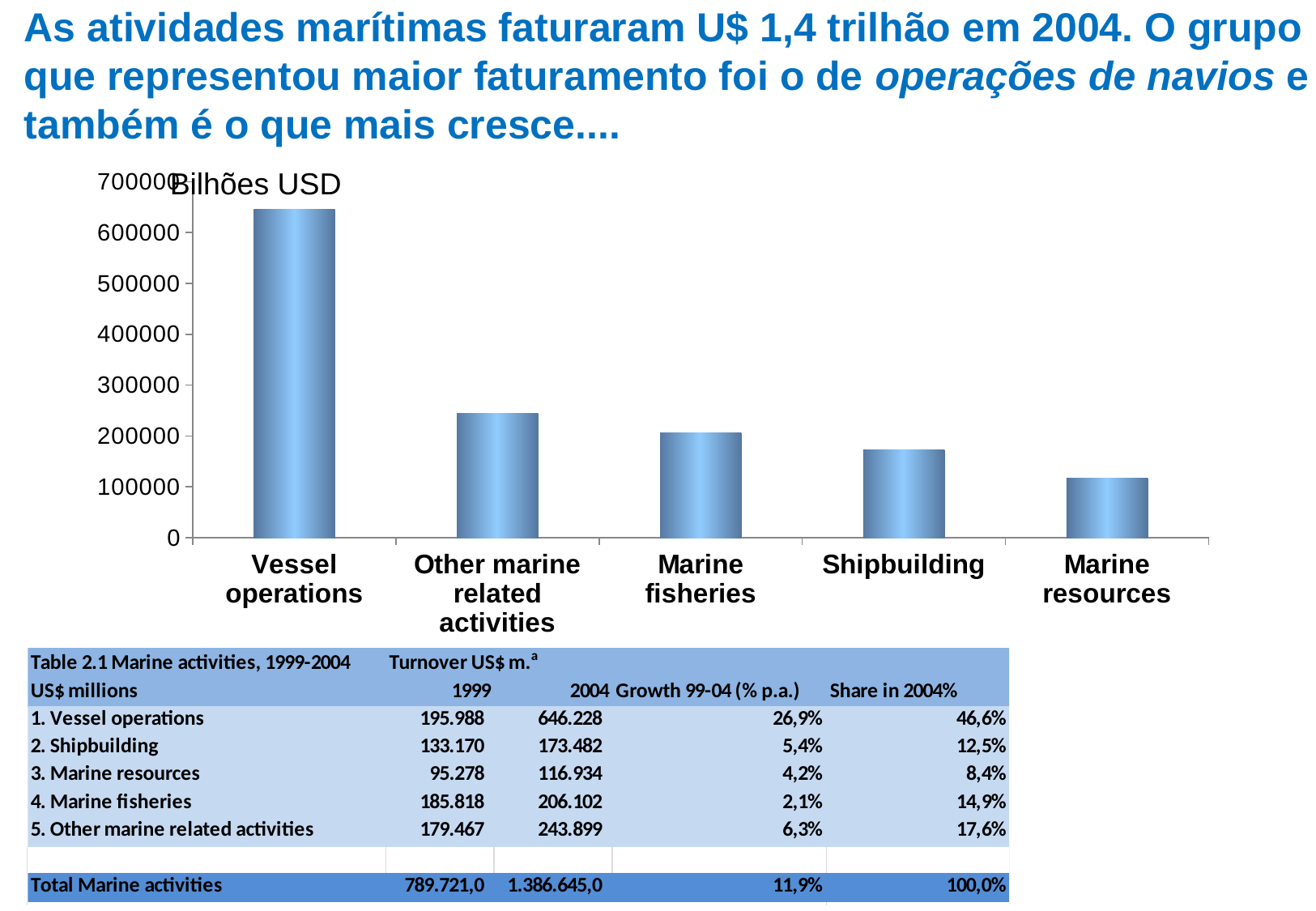
Which bar is taller: Shipbuilding or Marine resources? Shipbuilding Do the bar values rise or fall from left to right across the chart? fall How many categories are plotted in the bar chart? 5 Which category has the lowest bar in the chart? Marine resources Is the value for Other marine related activities greater or less than 300000? less Is the value for Shipbuilding greater or less than 200000? less Which bar is taller: Other marine related activities or Marine fisheries? Other marine related activities What kind of chart is shown on the slide? bar chart What unit label is shown at the top of the chart's vertical axis? Bilhões USD Which category has the highest bar in the chart? Vessel operations Is the value for Marine resources greater or less than 100000? greater